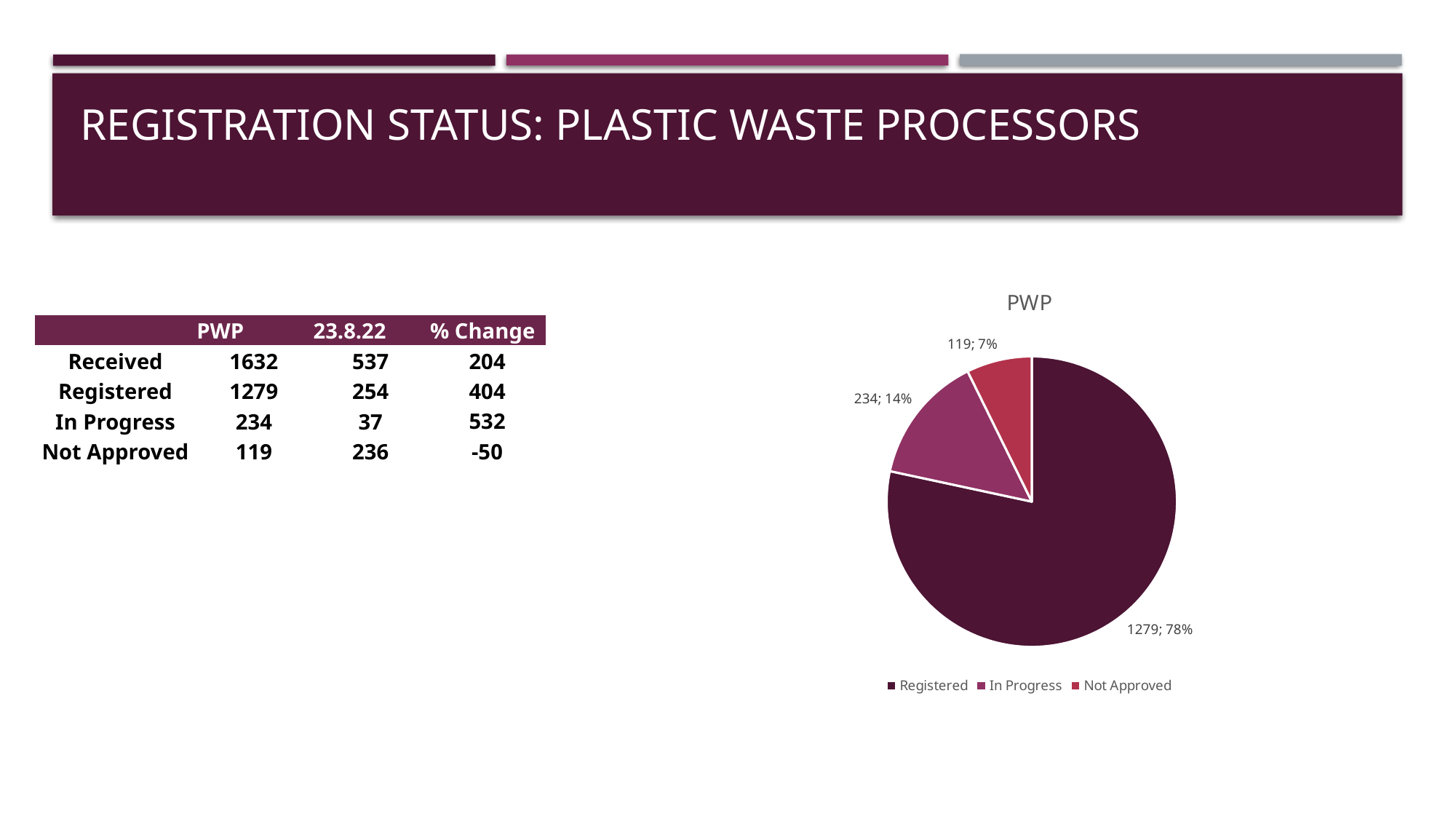
What is the value for Registered in the pie chart? 1279 Which category has the largest slice in the pie chart? Registered What is the difference between the Registered and In Progress values in the pie chart? 1045 What type of chart is shown on the slide? pie chart How many entries does the pie chart legend list? 3 Which category has the smallest slice in the pie chart? Not Approved How many slices does the pie chart have? 3 What share of the pie does In Progress represent? 14% What is the value for In Progress in the pie chart? 234 What is the title of the pie chart? PWP What share of the pie does Registered represent? 78% What is the value for Not Approved in the pie chart? 119